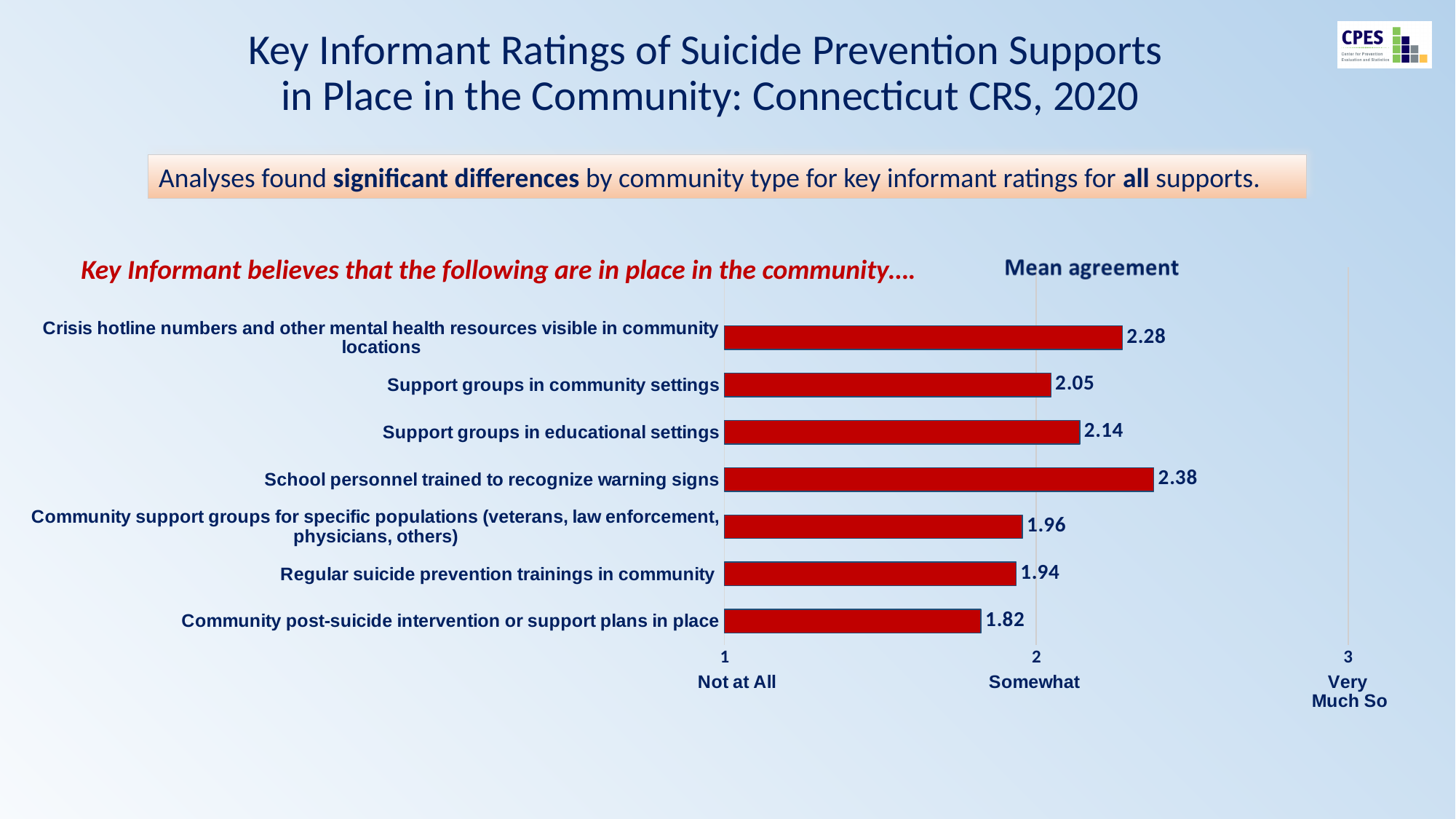
How many supports are rated in the chart? 7 What is the mean agreement for 'Community post-suicide intervention or support plans in place'? 1.82 What is the difference in mean agreement between 'Crisis hotline numbers and other mental health resources visible in community locations' and 'Support groups in community settings'? 0.23 Is the mean agreement for 'Regular suicide prevention trainings in community' greater or less than 2? less Which support has the highest mean agreement? School personnel trained to recognize warning signs What is the title above the bars on the right side of the chart? Mean agreement What label is shown at the value 3 on the axis? Very Much So What kind of chart is shown on the slide? Bar chart What is the mean agreement for 'School personnel trained to recognize warning signs'? 2.38 What is the mean agreement for 'Support groups in educational settings'? 2.14 Which has a higher mean agreement: 'Support groups in educational settings' or 'Support groups in community settings'? Support groups in educational settings Which support has the lowest mean agreement? Community post-suicide intervention or support plans in place